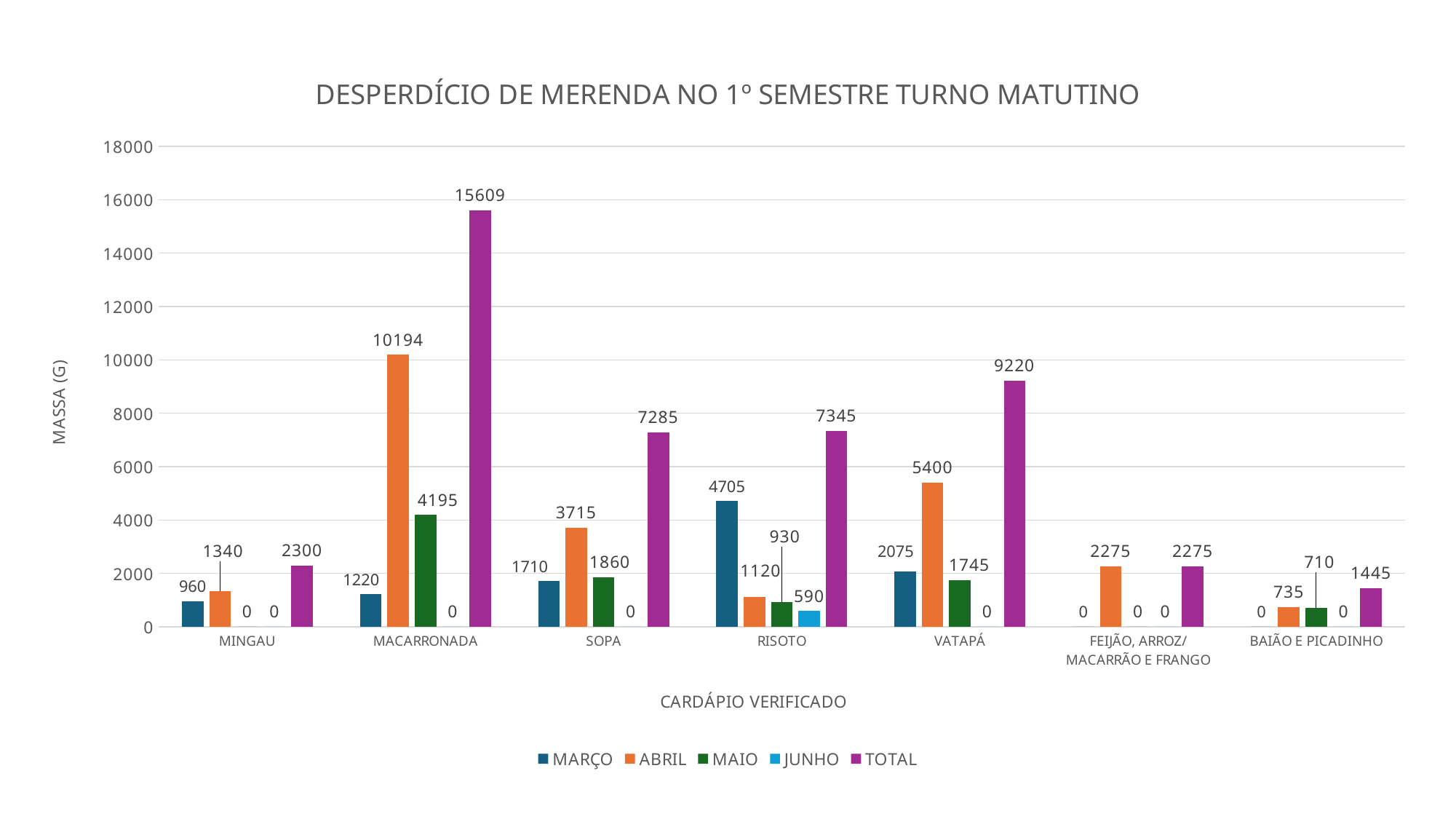
Is the TOTAL value for VATAPÁ greater or less than 8000? greater Which category has the lowest TOTAL value? BAIÃO E PICADINHO How many series does the legend list? 5 What is the ABRIL value for VATAPÁ? 5400 How many categories are shown on the x axis? 7 What kind of chart is shown on the slide? bar chart What is the TOTAL value for MACARRONADA? 15609 Which category has the highest TOTAL value? MACARRONADA Which is larger, the MARÇO value for RISOTO or the MARÇO value for VATAPÁ? RISOTO What is the title of the chart? DESPERDÍCIO DE MERENDA NO 1º SEMESTRE TURNO MATUTINO What is the difference between the TOTAL values for RISOTO and SOPA? 60 What is the JUNHO value for RISOTO? 590